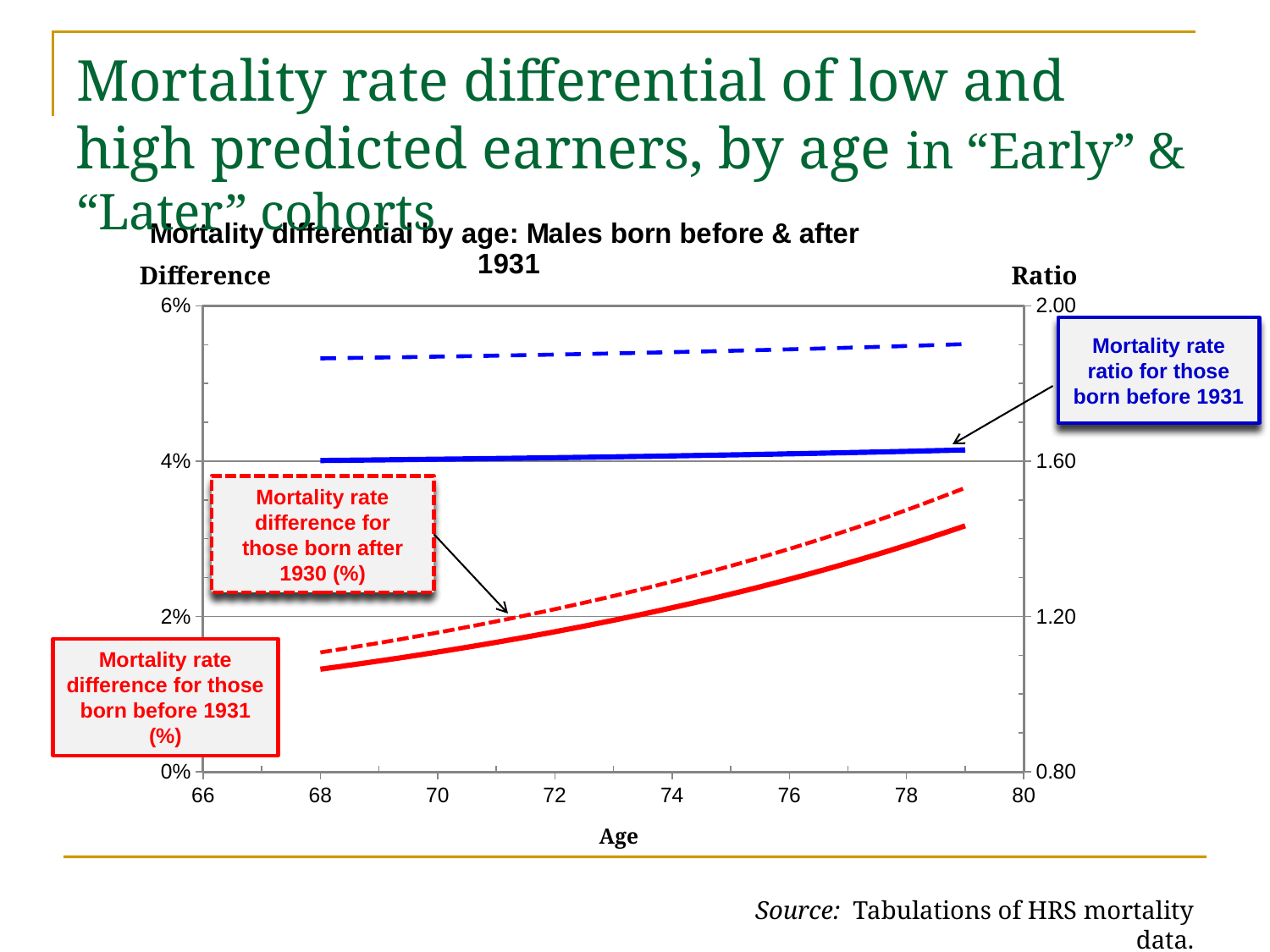
Does the mortality rate difference for those born before 1931 rise or fall as age increases? Rise Is the mortality rate difference for those born before 1931 at age 68 greater or less than 2%? less What is the label of the x axis of the chart? Age At age 79, which is larger: the mortality rate difference for those born after 1930 or for those born before 1931? Those born after 1930 How many lines are plotted on the chart? 4 What is the highest value shown on the right-hand Ratio axis? 2.00 What kind of chart is shown on the slide? Line chart Is the mortality rate difference for those born after 1930 at age 79 greater or less than 4%? less Is the value of the dashed blue line at age 78 greater or less than 1.60 on the Ratio axis? greater What is the title of the chart? Mortality differential by age: Males born before & after 1931 Does the mortality rate difference for those born after 1930 rise or fall as age increases? Rise